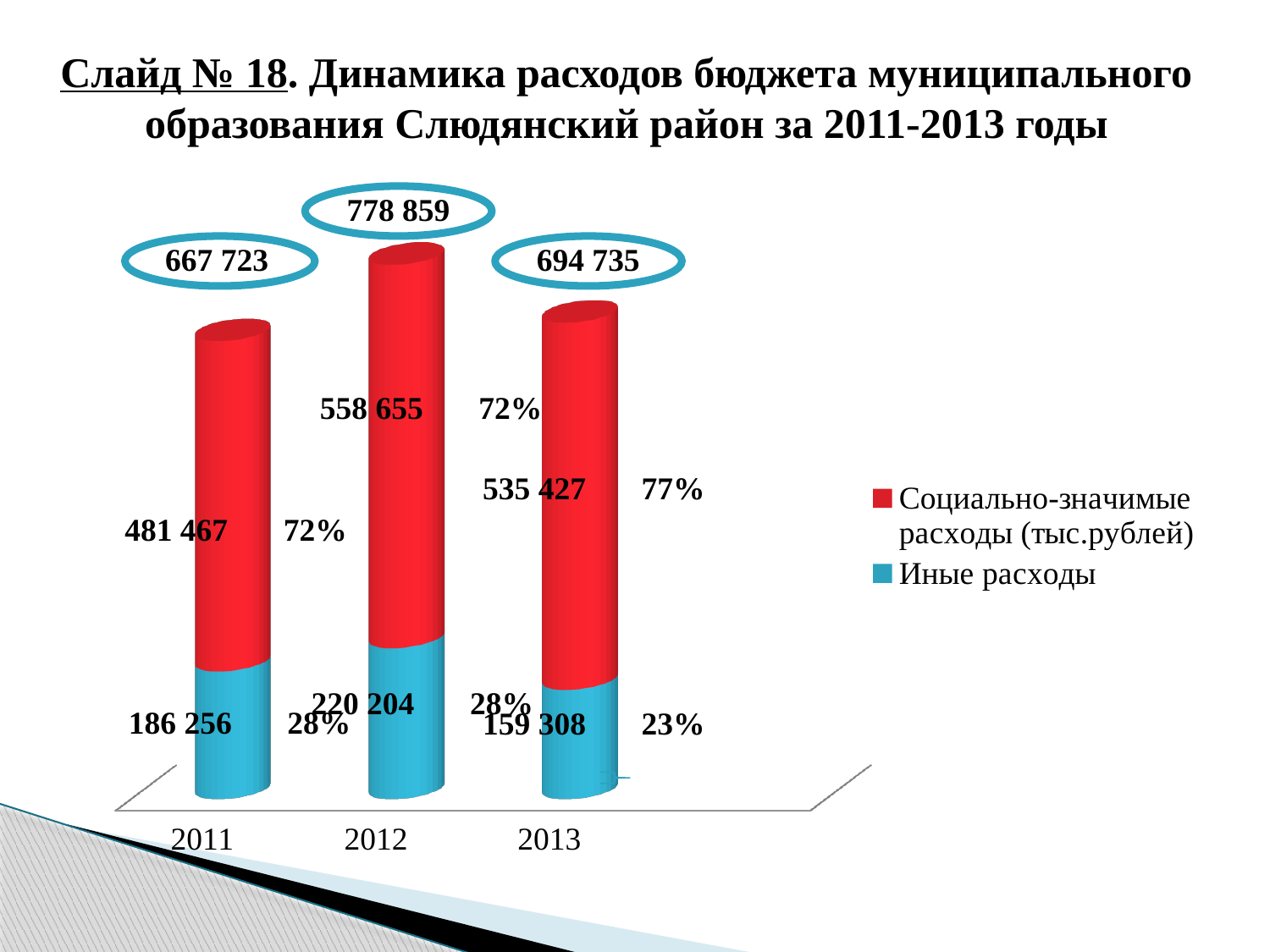
How many years are shown on the x axis? 3 What percentage share do Иные расходы make up in 2011? 28% What is the difference between the total expenditure in 2012 and 2011? 111 136 What is the value of Иные расходы for 2013? 159 308 What kind of chart is shown on the slide? Stacked bar chart What is the total expenditure shown for 2013? 694 735 Which year has the lowest value for Иные расходы? 2013 What is the difference between Социально-значимые расходы in 2012 and 2011? 77 188 How many series does the legend list? 2 What is the value of Социально-значимые расходы for 2012? 558 655 Which is larger: Иные расходы in 2012 or in 2013? 2012 Which year has the highest total expenditure? 2012